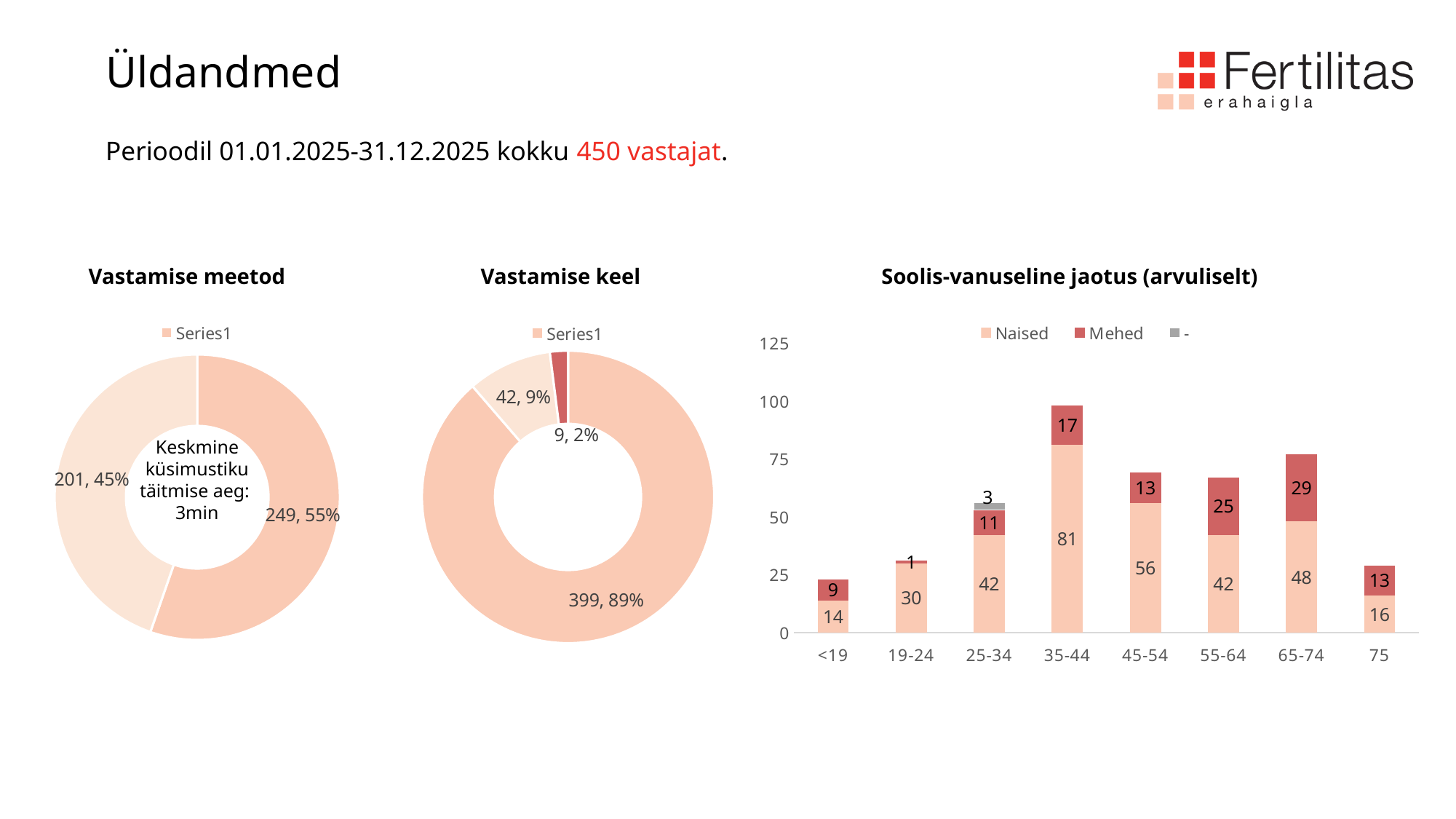
In the 'Soolis-vanuseline jaotus (arvuliselt)' chart, which age group has the lowest Mehed value? 19-24 In the 'Soolis-vanuseline jaotus (arvuliselt)' chart, what is the total of the stacked bar for the 25-34 age group? 56 In the 'Soolis-vanuseline jaotus (arvuliselt)' chart, what is the Naised value for the 35-44 age group? 81 What kind of chart is 'Soolis-vanuseline jaotus (arvuliselt)'? stacked bar chart In the 'Soolis-vanuseline jaotus (arvuliselt)' chart, is the Mehed value for 55-64 larger or smaller than the Mehed value for 45-54? larger In the 'Soolis-vanuseline jaotus (arvuliselt)' chart, how many series does the legend list? 3 In the 'Soolis-vanuseline jaotus (arvuliselt)' chart, how many age groups are shown on the x axis? 8 In the 'Vastamise meetod' chart, what share of the total does the largest slice represent? 55% In the 'Soolis-vanuseline jaotus (arvuliselt)' chart, what is the difference between the Naised values for 45-54 and 55-64? 14 In the 'Soolis-vanuseline jaotus (arvuliselt)' chart, what is the Mehed value for the 65-74 age group? 29 In the 'Vastamise keel' chart, what is the value of the largest slice? 399 In the 'Soolis-vanuseline jaotus (arvuliselt)' chart, which age group has the highest Naised value? 35-44